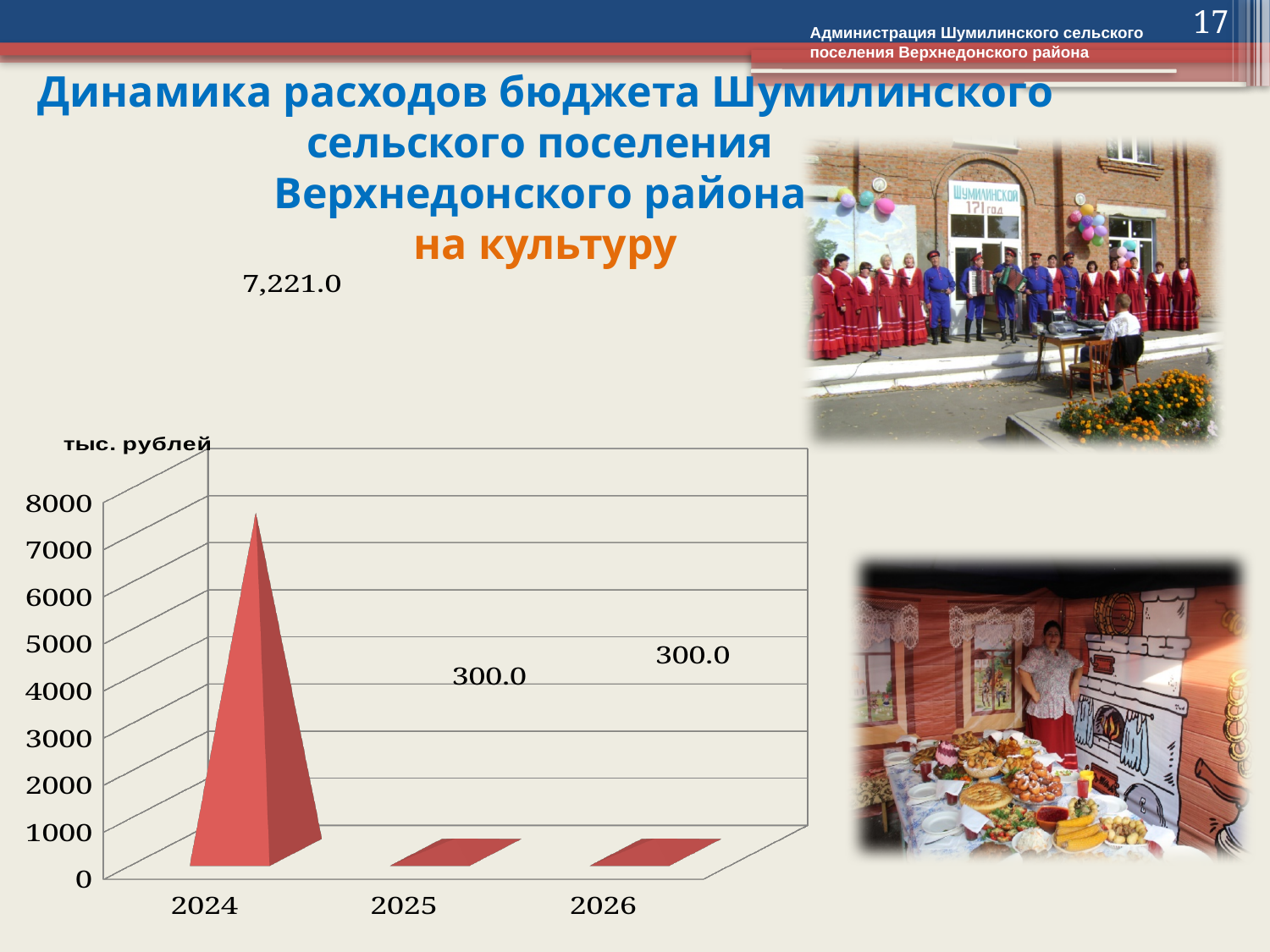
Which year has the highest value? 2024 What is the difference between the values for 2024 and 2025? 6,921.0 What unit is shown on the vertical axis of the chart? тыс. рублей Is the value for 2024 greater or less than 7000? greater What is the value for 2024? 7,221.0 What is the value for 2026? 300.0 Do the values rise or fall from 2024 to 2025? fall Which is larger, the value for 2024 or the value for 2026? 2024 How many years are shown on the x axis? 3 Is the value for 2025 greater or less than 1000? less What kind of chart is shown on the slide? bar chart What is the value for 2025? 300.0